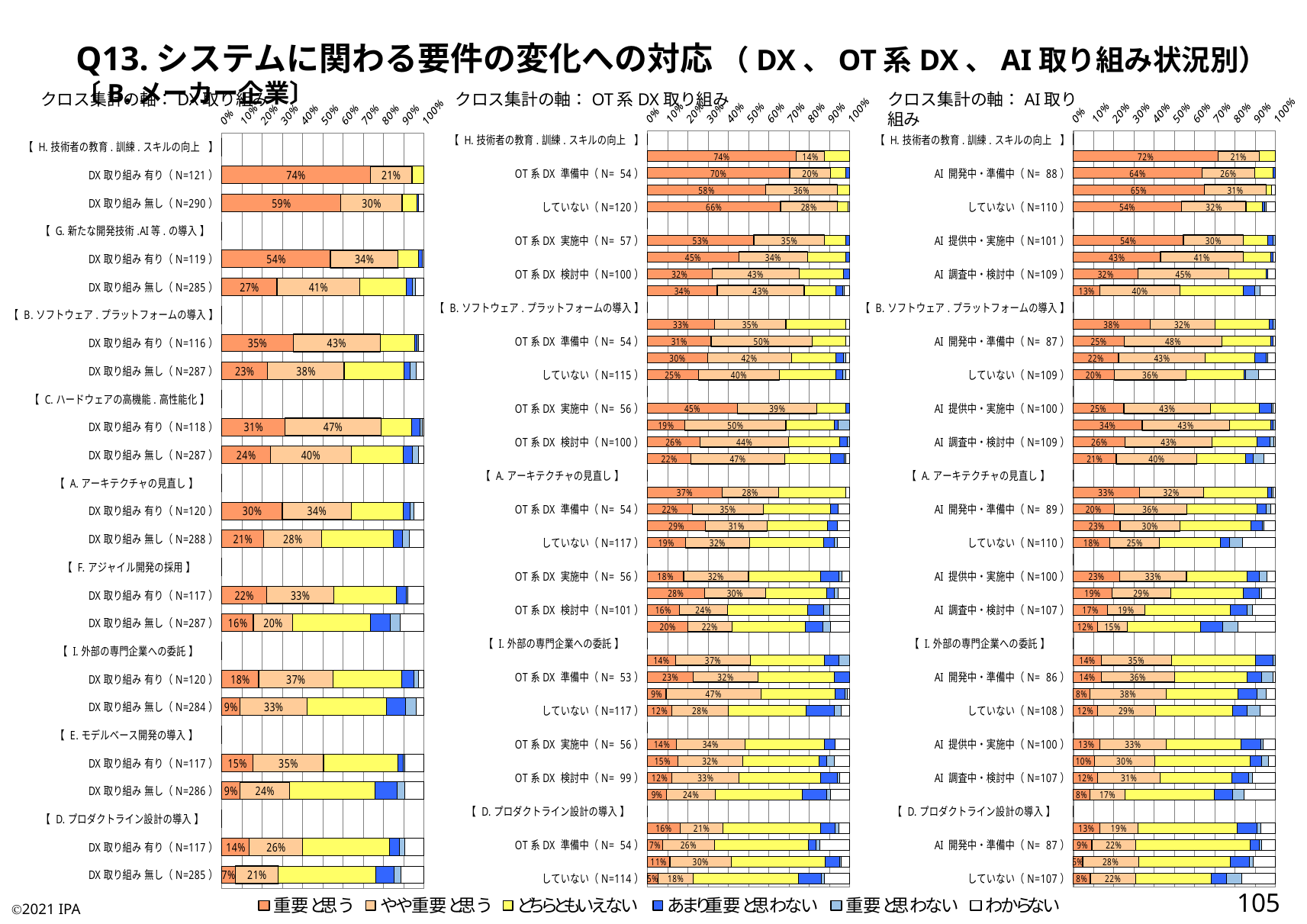
In the left chart (クロス集計の軸: DX取り組み), what percentage of DX取り組み有り (N=121) answered 重要と思う for H. 技術者の教育.訓練.スキルの向上? 74% In the left chart (クロス集計の軸: DX取り組み), for C. ハードウェアの高機能.高性能化 among DX取り組み有り (N=118), which is larger: 重要と思う or やや重要と思う? やや重要と思う In the left chart (クロス集計の軸: DX取り組み), what percentage of DX取り組み無し (N=285) answered 重要と思う for D. プロダクトライン設計の導入? 7% In the right chart (クロス集計の軸: AI取り組み), what percentage of AI開発中・準備中 (N=88) answered 重要と思う for H. 技術者の教育.訓練.スキルの向上? 64% In the left chart (クロス集計の軸: DX取り組み), for H. 技術者の教育.訓練.スキルの向上, how many percentage points higher is the 重要と思う share for DX取り組み有り (74%) than for DX取り組み無し (59%)? 15 percentage points What type of chart is used on this slide? Stacked horizontal bar chart In the middle chart (クロス集計の軸: OT系DX取り組み), what percentage of OT系DX準備中 (N=54) answered 重要と思う for H. 技術者の教育.訓練.スキルの向上? 70% How many response categories does the legend at the bottom of the slide list? 6 In the left chart (クロス集計の軸: DX取り組み), what percentage of DX取り組み無し (N=285) answered やや重要と思う for G. 新たな開発技術.AI等.の導入? 41% In the middle chart (クロス集計の軸: OT系DX取り組み), what percentage of していない (N=120) answered やや重要と思う for H. 技術者の教育.訓練.スキルの向上? 28% In the left chart (クロス集計の軸: DX取り組み), which row has the highest 重要と思う percentage? DX取り組み有り (N=121) for H. 技術者の教育.訓練.スキルの向上, 74%